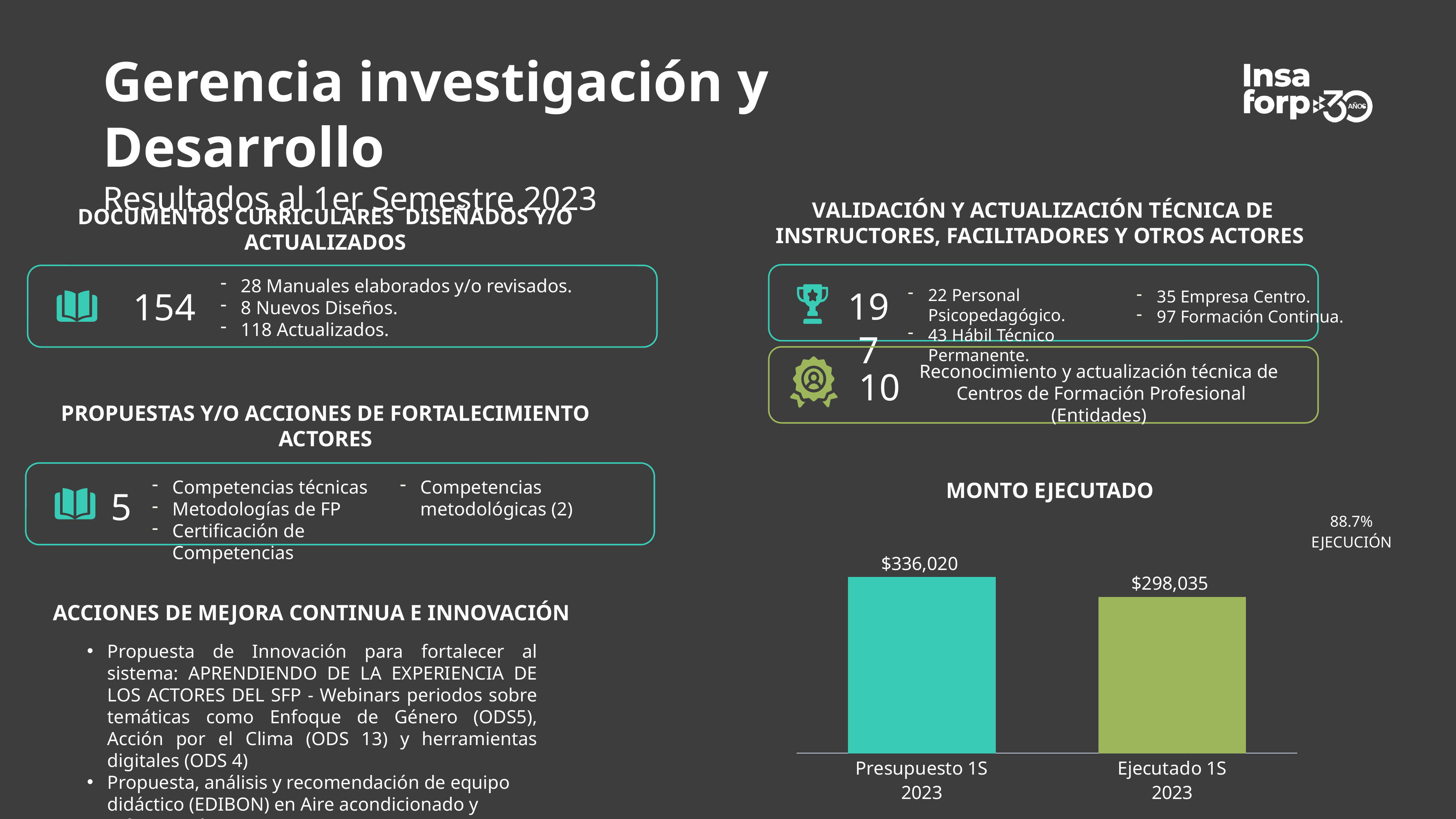
What kind of chart is the MONTO EJECUTADO chart? Bar chart Which category has the lowest value in the MONTO EJECUTADO chart? Ejecutado 1S 2023 What is the value for Presupuesto 1S 2023 in the MONTO EJECUTADO chart? $336,020 In the MONTO EJECUTADO chart, which is larger: Presupuesto 1S 2023 or Ejecutado 1S 2023? Presupuesto 1S 2023 What is the title of the bar chart on the slide? MONTO EJECUTADO Do the values rise or fall from Presupuesto 1S 2023 to Ejecutado 1S 2023 in the MONTO EJECUTADO chart? Fall What execution percentage is shown next to the MONTO EJECUTADO chart? 88.7% Which category has the highest value in the MONTO EJECUTADO chart? Presupuesto 1S 2023 How many bars are shown in the MONTO EJECUTADO chart? 2 What is the difference between Presupuesto 1S 2023 and Ejecutado 1S 2023 in the MONTO EJECUTADO chart? $37,985 What is the value for Ejecutado 1S 2023 in the MONTO EJECUTADO chart? $298,035